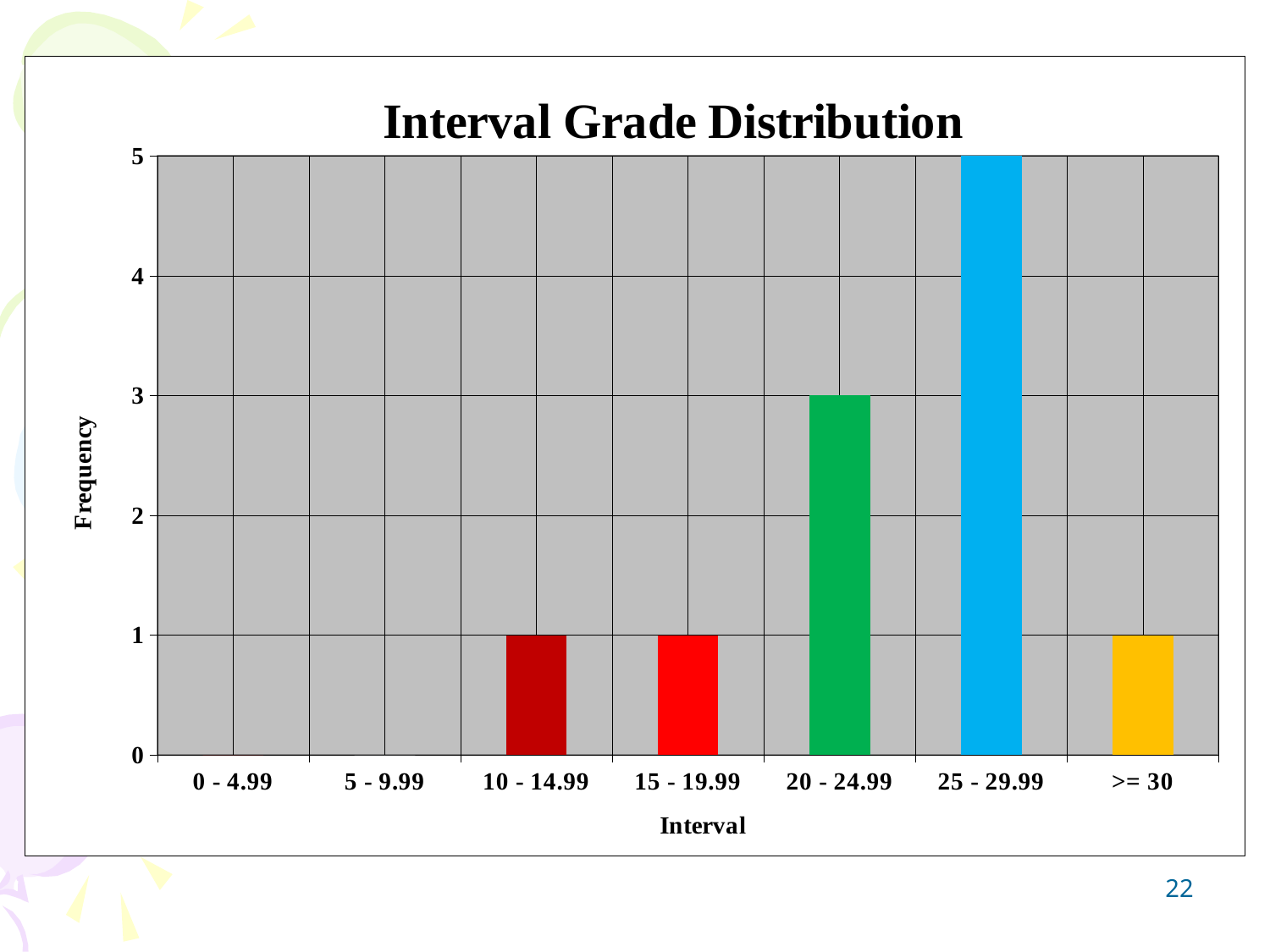
Which interval has the highest frequency? 25 - 29.99 How many intervals have a frequency of 1? 3 What is the frequency for the >= 30 interval? 1 What is the title of the chart? Interval Grade Distribution What type of chart is shown on the slide? bar chart What is the label of the y axis? Frequency What is the frequency for the 20 - 24.99 interval? 3 How many intervals are shown on the x axis? 7 What is the frequency for the 25 - 29.99 interval? 5 What is the difference in frequency between the 25 - 29.99 and 20 - 24.99 intervals? 2 What is the frequency for the 0 - 4.99 interval? 0 Which has a higher frequency, the 20 - 24.99 interval or the 15 - 19.99 interval? 20 - 24.99